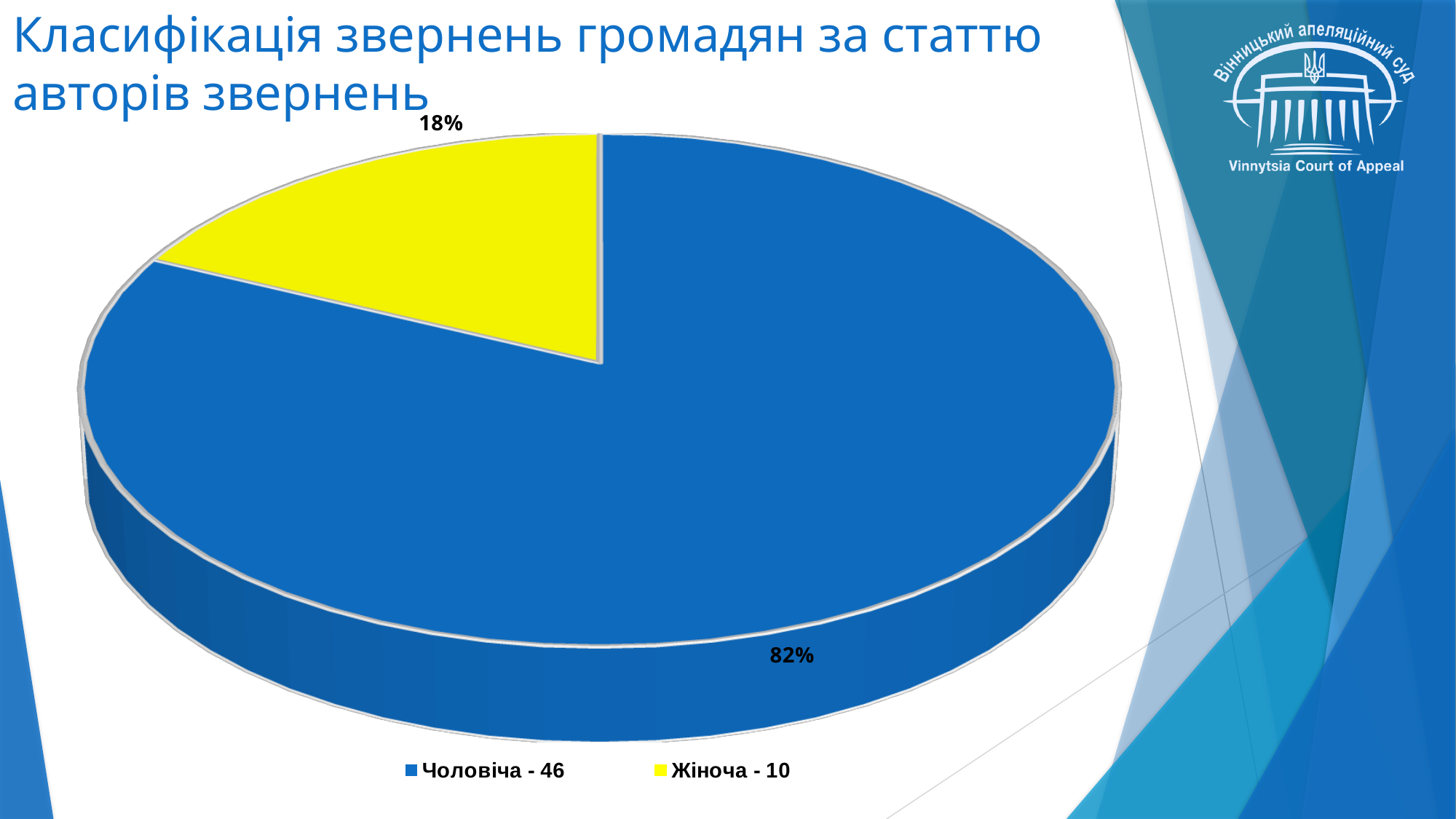
How many entries does the legend list? 2 What kind of chart is shown on the slide? Pie chart What is the difference in percentage points between the "Чоловіча" slice (82%) and the "Жіноча" slice (18%)? 64 percentage points Which category has the smallest slice of the pie? Жіноча - 10 According to the legend, how many appeals were from female authors (Жіноча)? 10 How many slices does the pie chart have? 2 Which slice is larger, "Чоловіча - 46" or "Жіноча - 10"? Чоловіча - 46 According to the legend, how many appeals were from male authors (Чоловіча)? 46 Which category has the largest slice of the pie? Чоловіча - 46 What share of the pie does the "Чоловіча - 46" slice represent? 82% What colour is the "Жіноча - 10" slice? Yellow What share of the pie does the "Жіноча - 10" slice represent? 18%